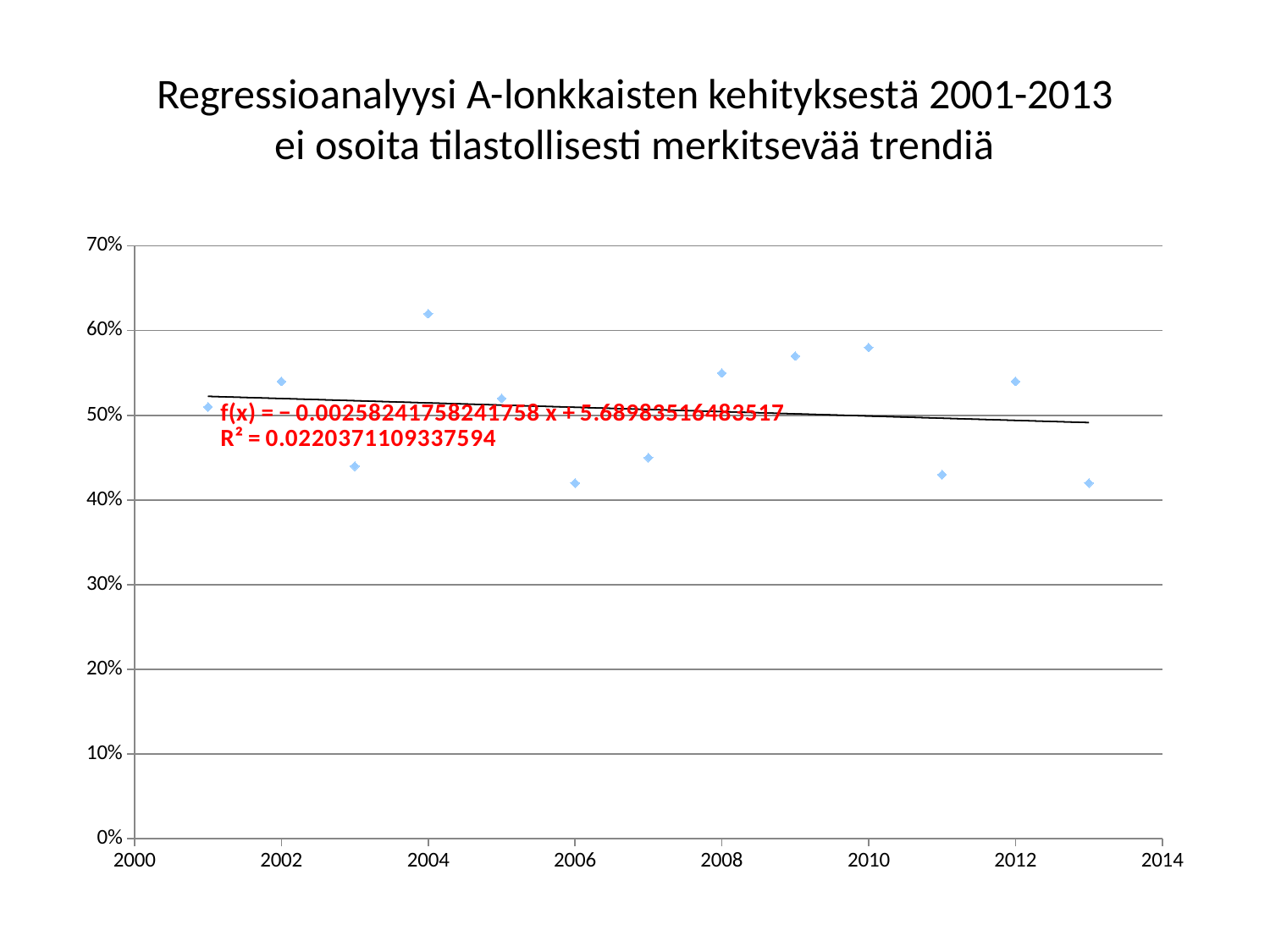
Which has the larger value, 2010 or 2011? 2010 Is the value for 2004 greater or less than 60%? greater How many data points are plotted in the chart? 13 Is the value for 2010 greater or less than 50%? greater Is the slope of the fitted trendline equation positive or negative? negative Which has the larger value, 2004 or 2003? 2004 Is the value for 2006 greater or less than 50%? less Which year has the highest plotted value? 2004 What R² value is printed on the chart? 0.0220371109337594 What is the title of the slide? Regressioanalyysi A-lonkkaisten kehityksestä 2001-2013 ei osoita tilastollisesti merkitsevää trendiä What kind of chart is shown on the slide? scatter chart